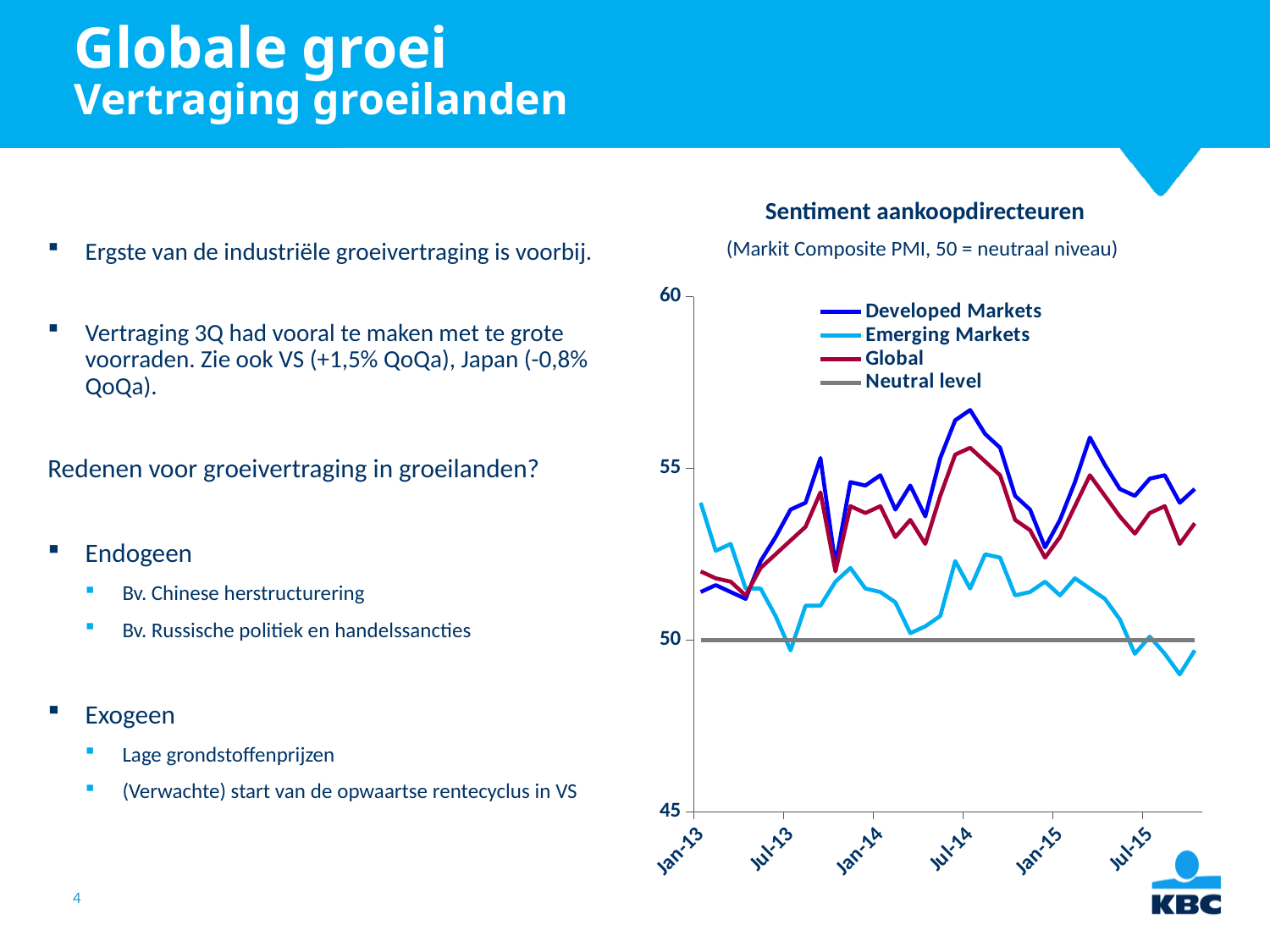
How many series does the chart legend list? 4 Which series has the highest value around Jul-14? Developed Markets Which series has the lowest value at the end of the chart (after Jul-15)? Emerging Markets Which series are listed in the chart legend? Developed Markets, Emerging Markets, Global, Neutral level What kind of chart is shown on the slide? line chart Is the value for Developed Markets at Jan-13 greater or less than 55? less How many date labels are shown on the x axis? 6 At what value does the Neutral level line sit? 50 Does the Emerging Markets line overall rise or fall from Jan-13 to the end of the chart? fall What is the title of the chart? Sentiment aankoopdirecteuren Is the value for Developed Markets around Jul-14 greater or less than 55? greater Is the value for Emerging Markets at Jan-13 greater or less than 50? greater